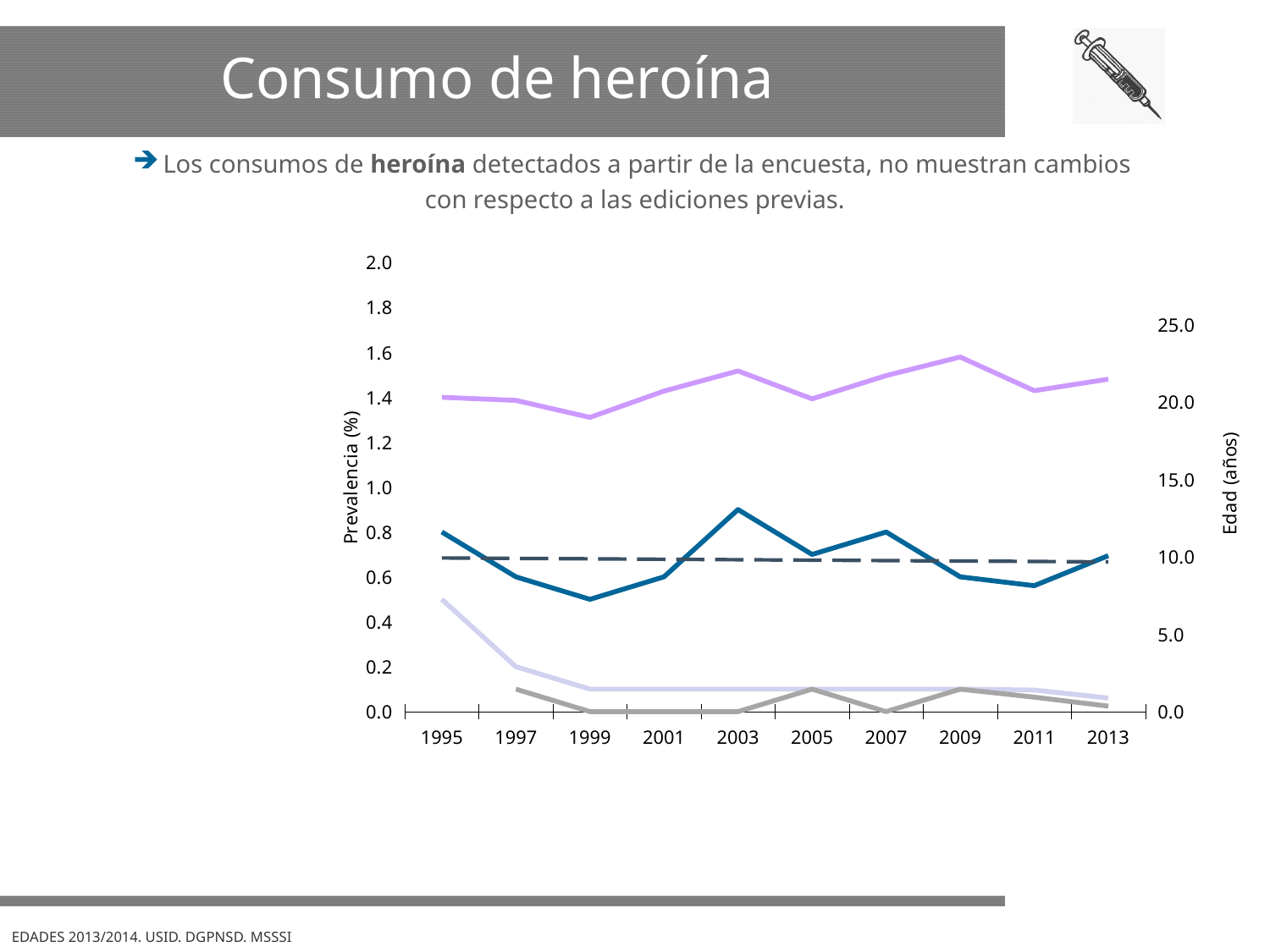
What is the highest tick value on the right vertical axis of the chart? 25.0 What is the title of the left vertical axis of the chart? Prevalencia (%) What is the first year shown on the x axis of the chart? 1995 What kind of chart is shown on the slide? line chart Is the value of the dark blue line at 1999 greater or less than 0.6 on the left axis? less What is the highest tick value on the left vertical axis of the chart? 2.0 What is the last year shown on the x axis of the chart? 2013 Is the value of the dark blue line at 2003 greater or less than 0.8 on the left axis? greater How many years are labelled along the x axis of the chart? 10 What is the title of the right vertical axis of the chart? Edad (años) Does the dark blue line rise or fall between 1995 and 1999? fall Does the dark blue line rise or fall between 2001 and 2003? rise